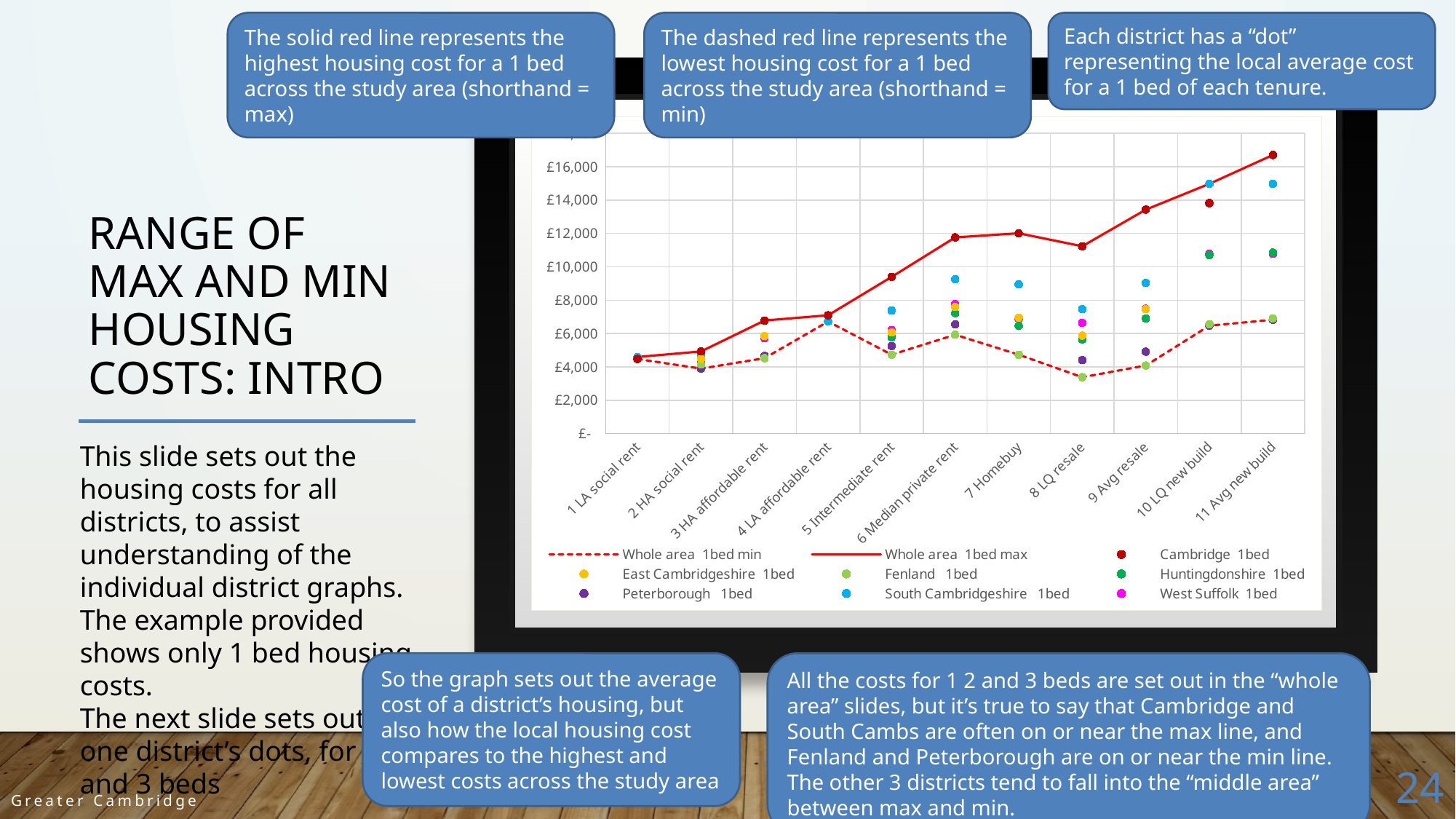
Does the Whole area 1bed max line generally rise or fall from 1 LA social rent to 11 Avg new build? rise Is the Whole area 1bed min value for 8 LQ resale greater or less than £4,000? less Which category has the highest value on the Whole area 1bed max line? 11 Avg new build Which legend entry is drawn as a dashed red line? Whole area 1bed min Which category has the lowest value on the Whole area 1bed min line? 8 LQ resale Is the Whole area 1bed max value for 6 Median private rent greater or less than £10,000? greater How many tenure categories are shown along the x axis of the chart? 11 How many series does the chart's legend list? 9 What kind of chart is shown on the slide? line chart Is the Whole area 1bed max value for 11 Avg new build greater or less than £16,000? greater At 8 LQ resale, which is larger: the Fenland 1bed value or the South Cambridgeshire 1bed value? South Cambridgeshire 1bed